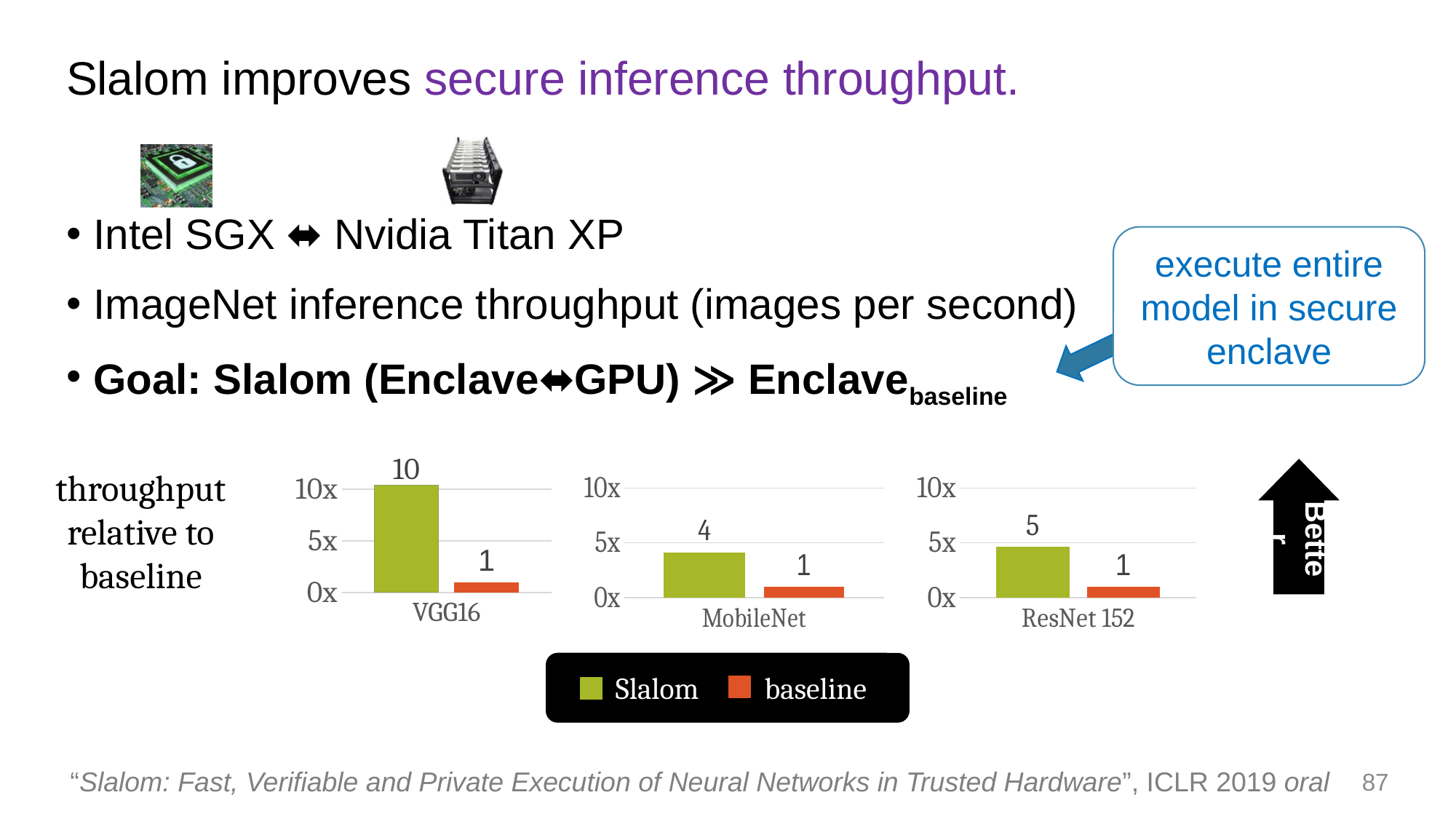
In the MobileNet chart, what is the difference between the Slalom and baseline values? 3 In the VGG16 chart, what is the value for Slalom? 10 In the ResNet 152 chart, what is the value for baseline? 1 In the ResNet 152 chart, which is larger, Slalom or baseline? Slalom In the ResNet 152 chart, what is the value for Slalom? 5 Which colour represents Slalom in the legend? green In the MobileNet chart, what is the value for Slalom? 4 Across the three charts, which model has the highest Slalom value? VGG16 How many series does the legend list? 2 Across the three charts, which model has the lowest Slalom value? MobileNet In the VGG16 chart, what is the difference between the Slalom and baseline values? 9 What kind of chart is the VGG16 chart? bar chart